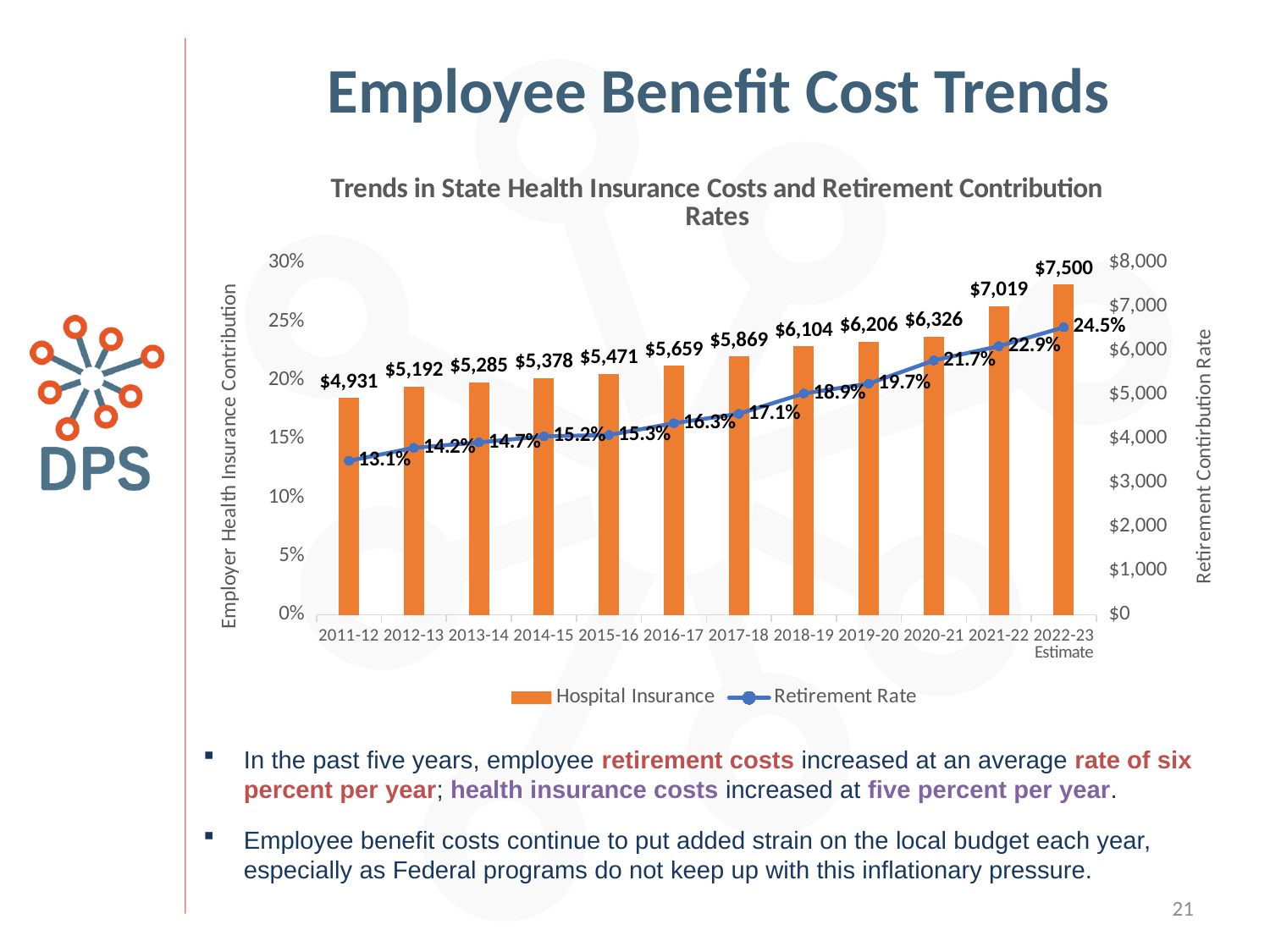
What is the difference in Hospital Insurance between 2022-23 Estimate and 2021-22? $481 Which year has the highest Hospital Insurance value? 2022-23 Estimate Does the Retirement Rate rise or fall from 2011-12 to 2022-23 Estimate? rise Which year has the lowest Retirement Rate? 2011-12 What is the Retirement Rate for 2022-23 Estimate? 24.5% What is the Hospital Insurance value for 2017-18? $5,869 Which is larger, the Hospital Insurance value for 2015-16 or for 2016-17? 2016-17 How many years are shown on the x axis? 12 What is the difference in Retirement Rate between 2020-21 and 2019-20? 2.0% What is the Retirement Rate for 2019-20? 19.7% What is the Hospital Insurance value for 2011-12? $4,931 How many series does the legend list? 2